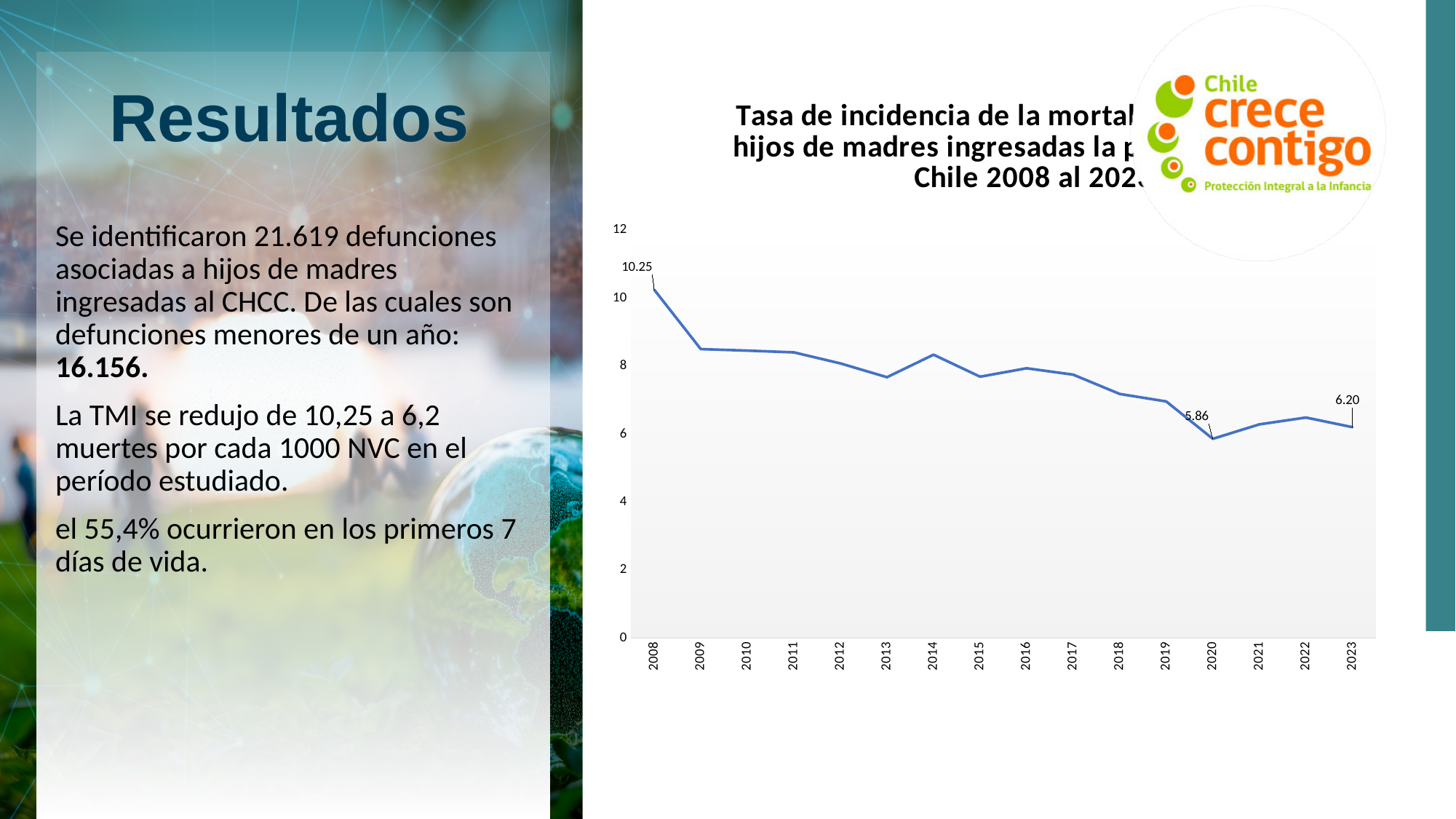
What is the value for 2023? 6.20 What is the value for 2008? 10.25 Do the values generally rise or fall from 2008 to 2023? fall Which is larger, the value for 2020 or the value for 2023? 2023 Which year has the highest value? 2008 What is the difference between the values for 2008 and 2020? 4.39 What kind of chart is shown on the slide? line chart How many years are plotted on the x axis? 16 Which year has the lowest value? 2020 Is the value for 2018 greater or less than 8? less What is the value for 2020? 5.86 What is the difference between the values for 2008 and 2023? 4.05